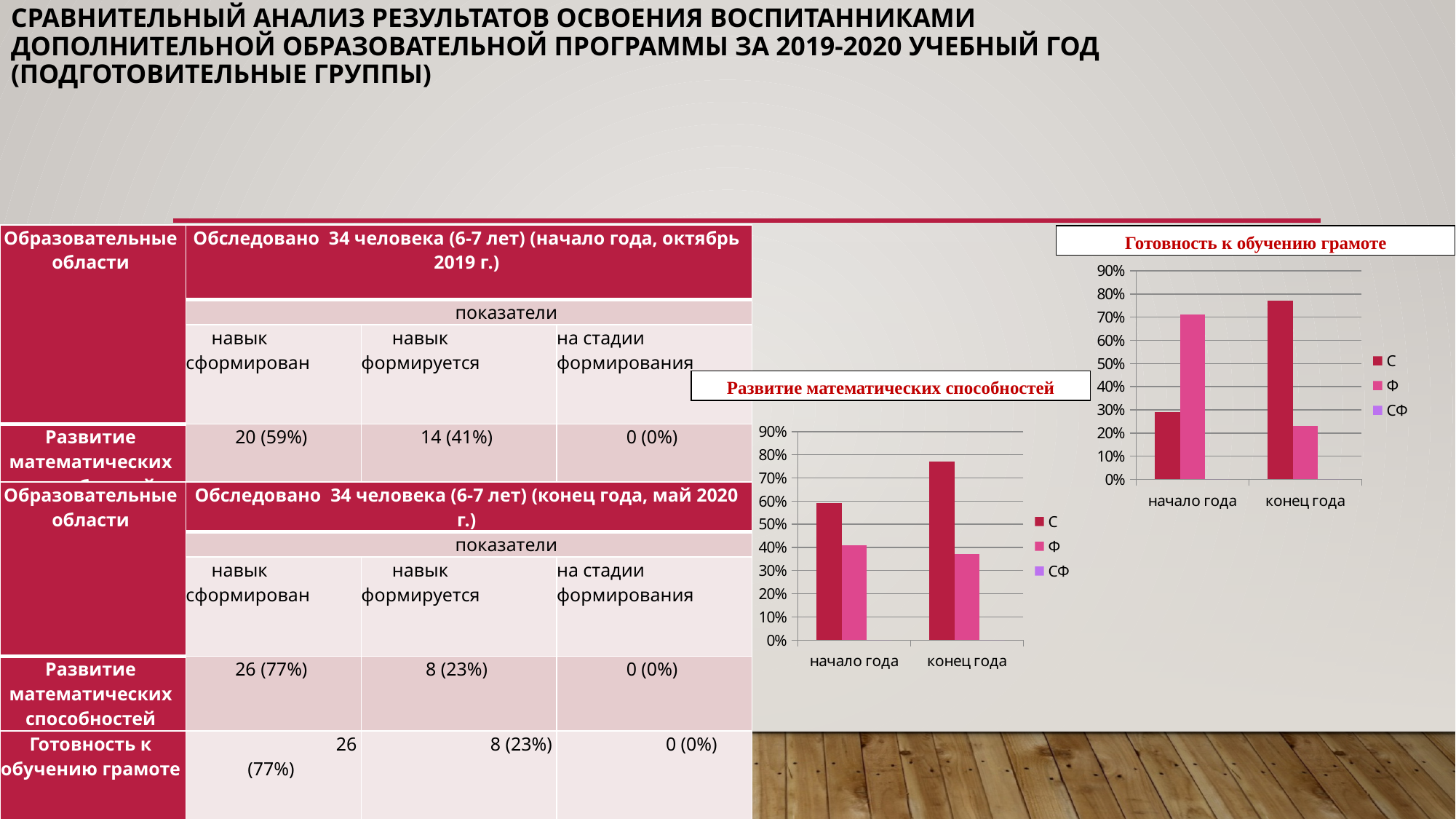
On the chart titled "Готовность к обучению грамоте", is the value for series С at "начало года" greater or less than 40%? less On the chart titled "Развитие математических способностей", how many series does the legend list? 3 On the chart titled "Развитие математических способностей", does series С rise or fall from "начало года" to "конец года"? rises On the chart titled "Готовность к обучению грамоте", which series has the highest value at "конец года"? С On the chart titled "Готовность к обучению грамоте", which series has the highest value at "начало года"? Ф On the chart titled "Готовность к обучению грамоте", what are the legend entries? С, Ф, СФ On the chart titled "Развитие математических способностей", is the value for series С at "начало года" greater or less than 50%? greater On the chart titled "Развитие математических способностей", is the value for series Ф at "конец года" greater or less than 50%? less On the chart titled "Готовность к обучению грамоте", how many categories are shown on the x axis? 2 On the chart titled "Готовность к обучению грамоте", does series Ф rise or fall from "начало года" to "конец года"? falls On the chart titled "Развитие математических способностей", what kind of chart is shown? bar chart On the chart titled "Развитие математических способностей", which is larger for series С: "начало года" or "конец года"? конец года